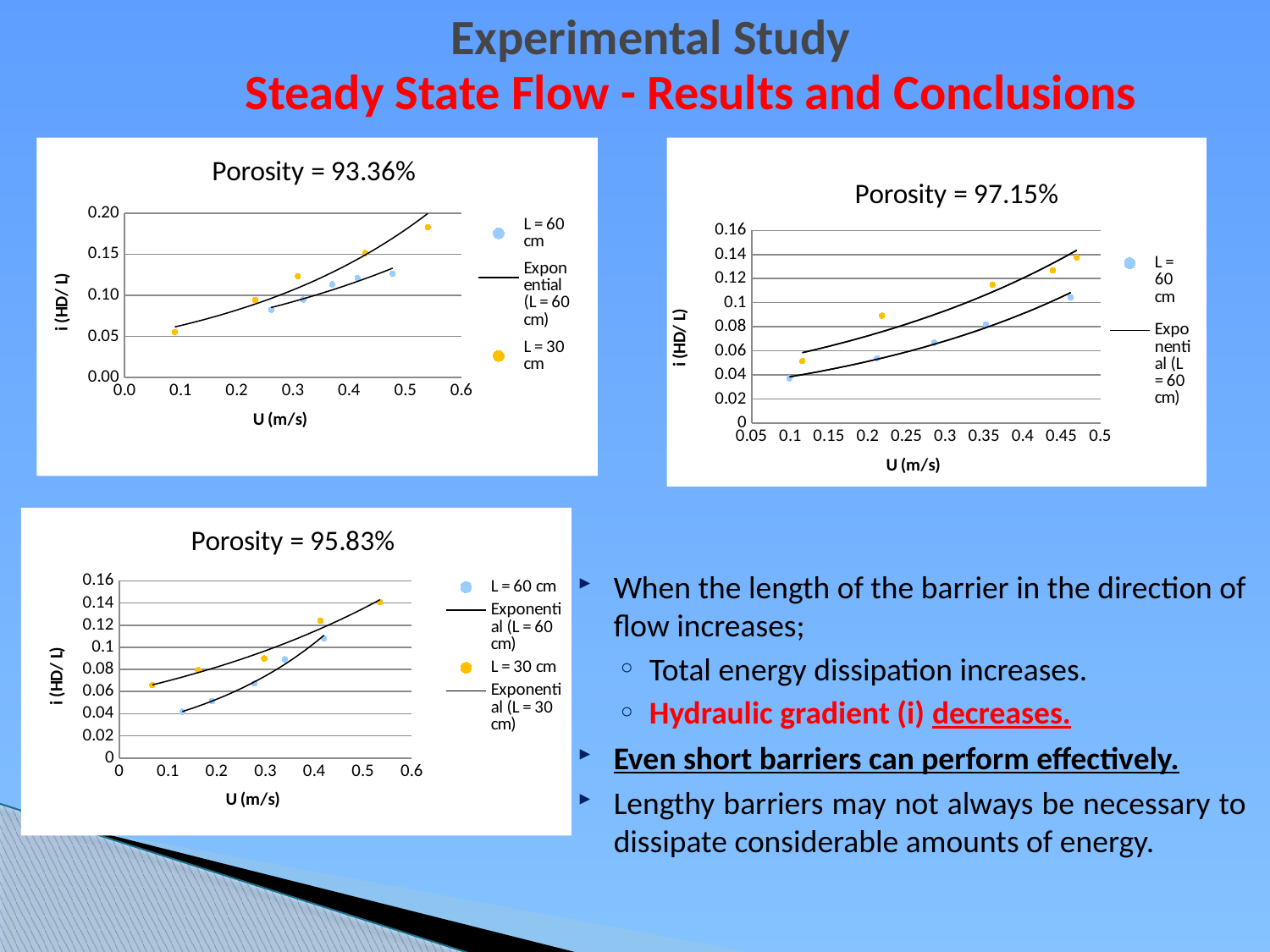
In the 'Porosity = 95.83%' chart, is the highest i (HD/L) value for L = 60 cm greater or less than 0.12? less In the 'Porosity = 97.15%' chart, is the highest i (HD/L) value for L = 60 cm greater or less than 0.12? less In the 'Porosity = 97.15%' chart, do the i (HD/L) values rise or fall as U (m/s) increases? rise In the 'Porosity = 93.36%' chart, do the i (HD/L) values rise or fall as U (m/s) increases? rise In the 'Porosity = 93.36%' chart, is the highest i (HD/L) value for L = 30 cm greater or less than 0.15? greater What is the title of the chart in the top right of the slide? Porosity = 97.15% How many series does the legend of the 'Porosity = 97.15%' chart list? 2 What kind of chart is the 'Porosity = 93.36%' chart? scatter chart How many series does the legend of the 'Porosity = 93.36%' chart list? 3 How many series does the legend of the 'Porosity = 95.83%' chart list? 4 What is the label of the x axis on the 'Porosity = 95.83%' chart? U (m/s)